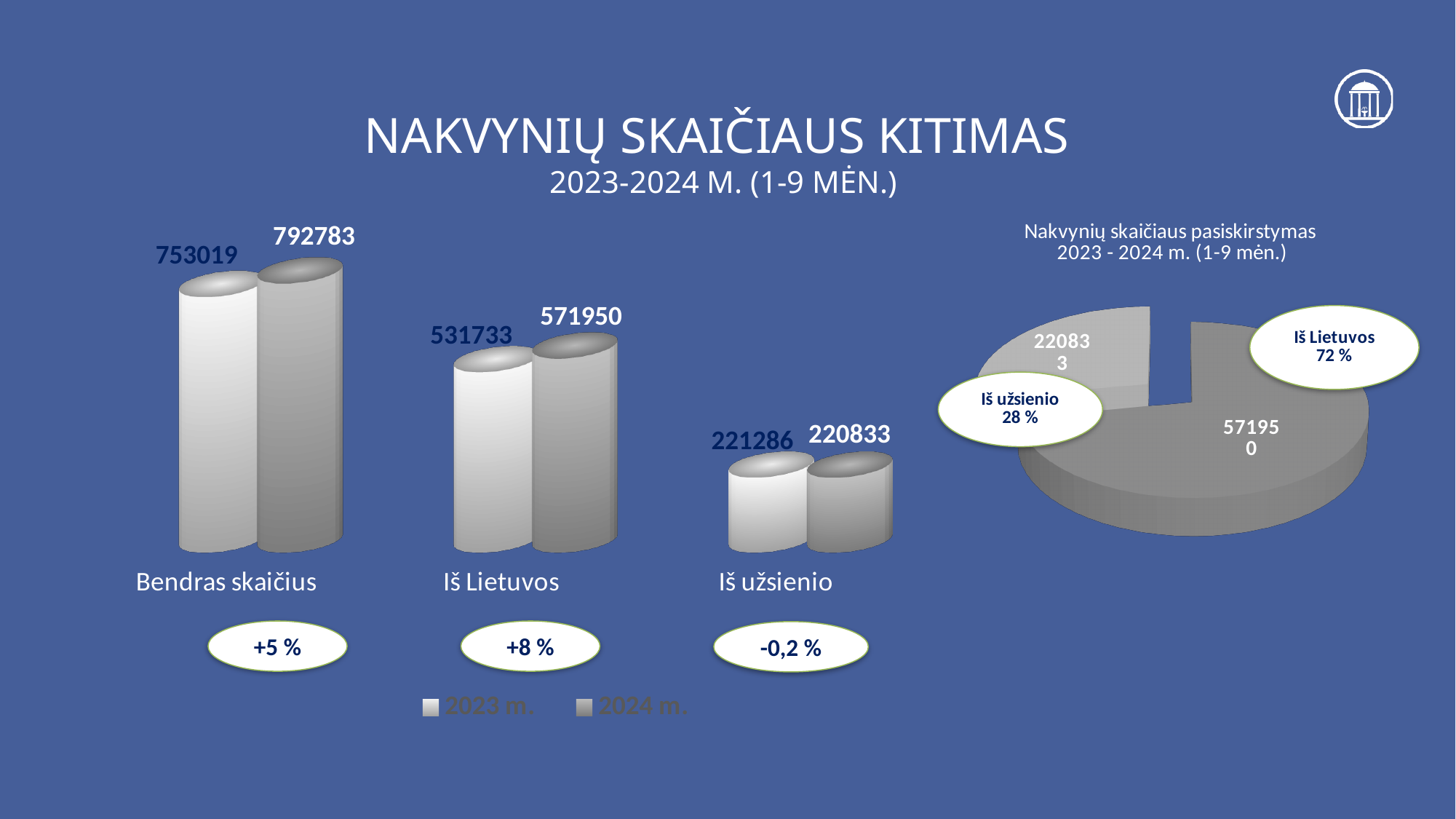
What type of chart is the chart on the right titled 'Nakvynių skaičiaus pasiskirstymas'? Pie chart In the bar chart on the left, what is the difference between the 2024 m. and 2023 m. values for Bendras skaičius? 39764 How many categories are shown in the bar chart on the left? 3 In the bar chart on the left, what is the difference between the 2024 m. and 2023 m. values for Iš Lietuvos? 40217 In the bar chart on the left, which category has the highest value in 2024 m.? Bendras skaičius In the bar chart on the left, which is larger for Iš Lietuvos: the 2023 m. value or the 2024 m. value? 2024 m. How many series does the legend of the bar chart on the left list? 2 In the bar chart on the left, what is the value for Bendras skaičius in 2024 m.? 792783 In the pie chart on the right, what share of the total does Iš Lietuvos have? 72 % In the bar chart on the left, which category has the lowest value in 2023 m.? Iš užsienio In the bar chart on the left, what is the value for Iš Lietuvos in 2023 m.? 531733 In the bar chart on the left, what is the value for Iš užsienio in 2024 m.? 220833